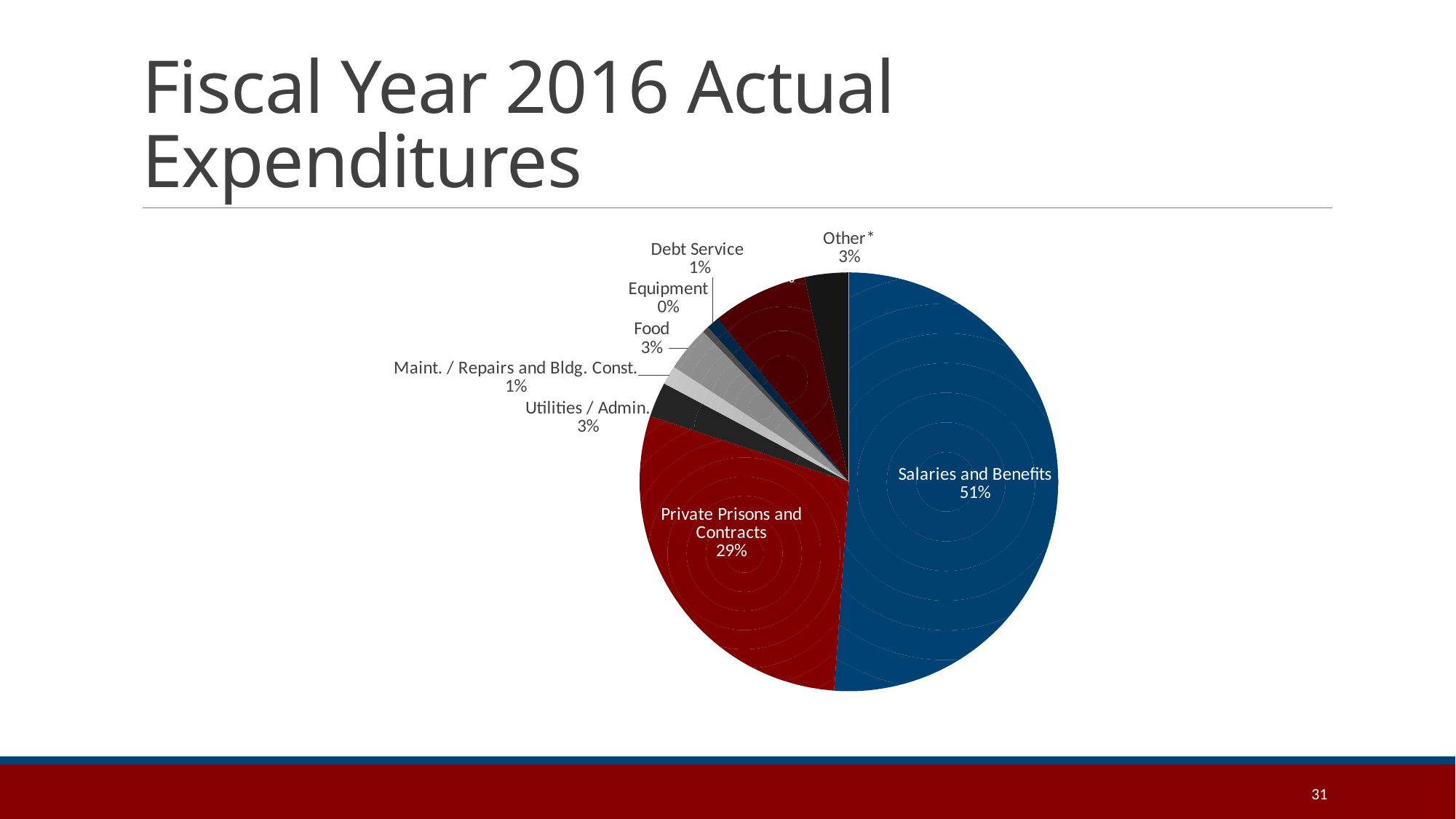
What percentage is shown for Debt Service? 1% What type of chart is shown on the slide? pie chart Which category has the smallest share of the pie? Equipment What percentage is shown for Equipment? 0% What share of expenditures is Private Prisons and Contracts? 29% What percentage is shown for Maint. / Repairs and Bldg. Const.? 1% What is the title of the slide containing the chart? Fiscal Year 2016 Actual Expenditures Which is larger, Utilities / Admin. or Debt Service? Utilities / Admin. What share of expenditures is Salaries and Benefits? 51% Which category has the largest share of the pie? Salaries and Benefits How many percentage points larger is Salaries and Benefits than Private Prisons and Contracts? 22 What percentage is shown for Food? 3%